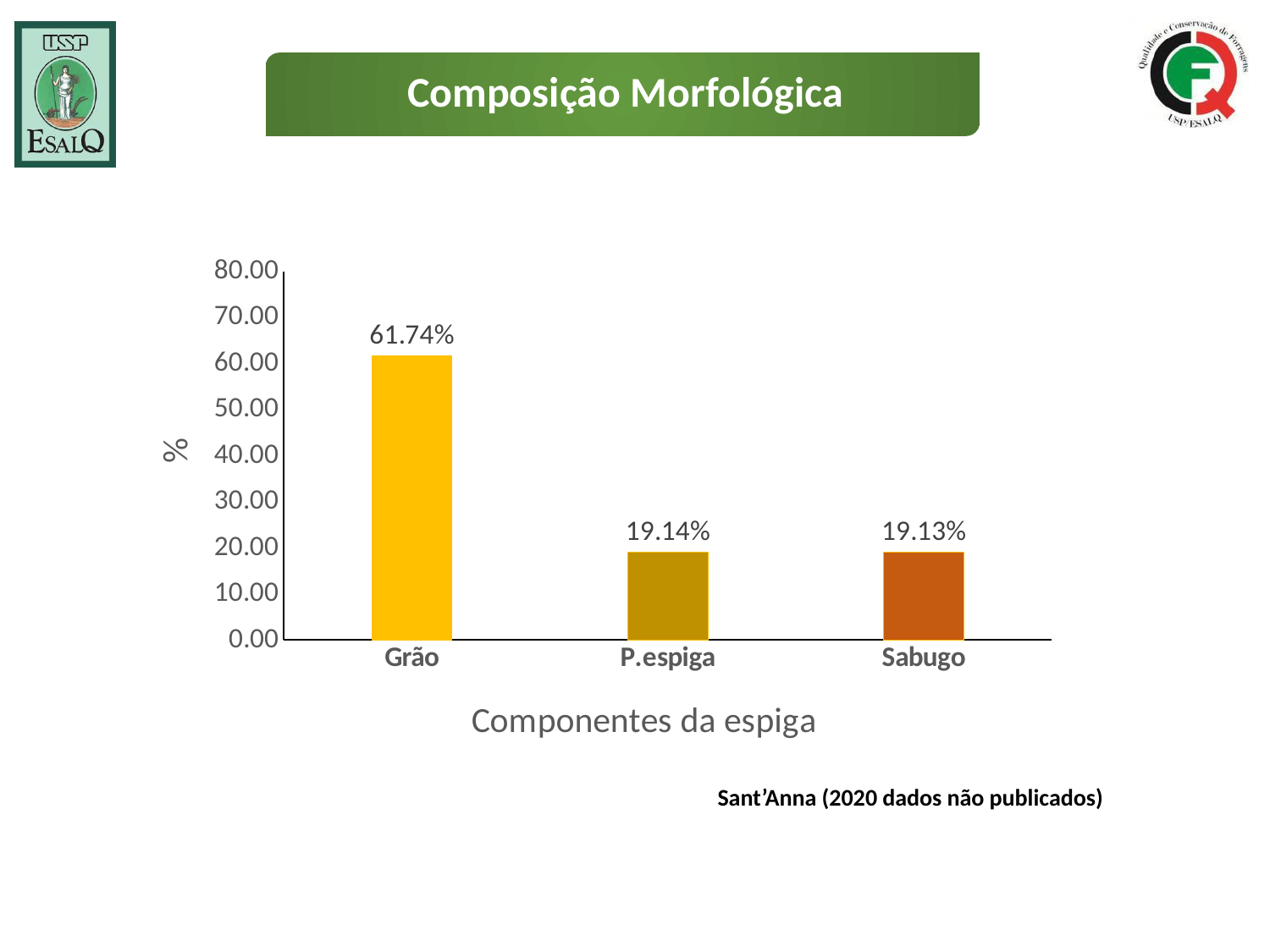
What kind of chart is shown on the slide? bar chart What is the value for P.espiga? 19.14% Is the value for P.espiga greater or less than 30? less Is the value for Grão greater or less than 50? greater How many components are shown on the x axis? 3 What is the value for Sabugo? 19.13% What is the label of the x axis? Componentes da espiga Which is larger, the value for Grão or the value for Sabugo? Grão What is the difference between the values for Grão and P.espiga? 42.60% What is the difference between the values for Grão and Sabugo? 42.61% What is the value for Grão? 61.74% Which component has the highest value? Grão